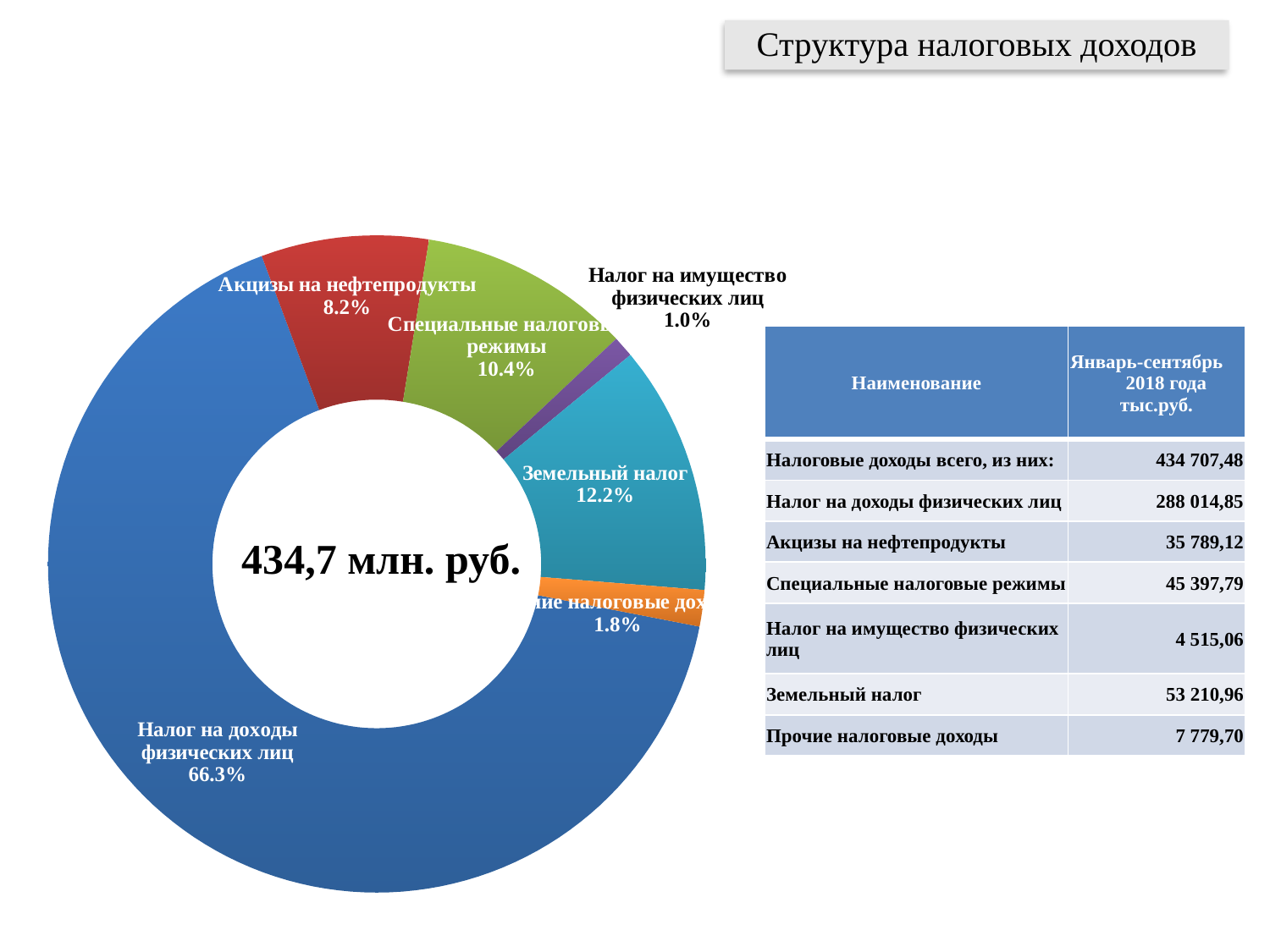
Which share is larger in the chart: "Земельный налог" or "Акцизы на нефтепродукты"? Земельный налог What percentage is shown for "Налог на имущество физических лиц" in the chart? 1.0% What percentage is shown for "Специальные налоговые режимы" in the chart? 10.4% What share of tax revenues does "Налог на доходы физических лиц" account for in the chart? 66.3% What percentage is shown for "Акцизы на нефтепродукты" in the chart? 8.2% Which category has the largest share in the chart? Налог на доходы физических лиц Which category has the smallest share in the chart? Налог на имущество физических лиц How many slices does the doughnut chart have? 6 What percentage is shown for "Земельный налог" in the chart? 12.2% What total amount is written in the centre of the doughnut chart? 434,7 млн. руб. What is the difference in percentage points between "Земельный налог" and "Специальные налоговые режимы" in the chart? 1.8 percentage points What kind of chart is shown on the slide? Doughnut (pie) chart